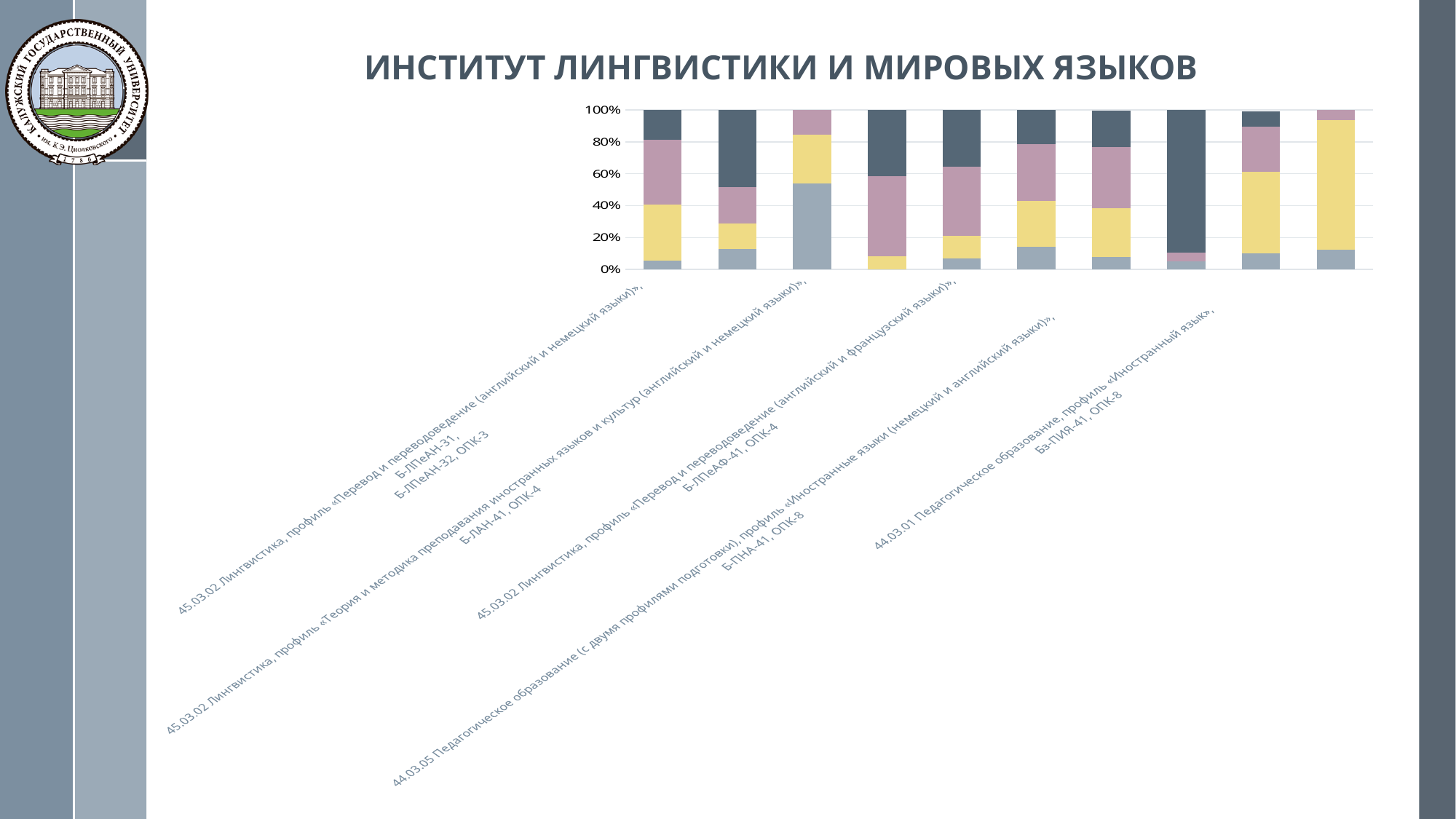
Which bar has the largest top (dark) segment? The eighth bar from the left What is the title of the slide above the chart? ИНСТИТУТ ЛИНГВИСТИКИ И МИРОВЫХ ЯЗЫКОВ How many bars are plotted in the chart? 10 Is the top (dark) segment of the eighth bar from the left greater or less than 80% of the bar? greater What is the highest value shown on the vertical axis of the chart? 100% Which bar has the larger bottom (grey) segment: the third bar from the left or the leftmost bar? The third bar from the left Is the bottom (grey) segment of the leftmost bar greater or less than 20%? less Is the yellow segment of the rightmost bar greater or less than 60% of the bar? greater What kind of chart is shown on the slide? Stacked bar chart